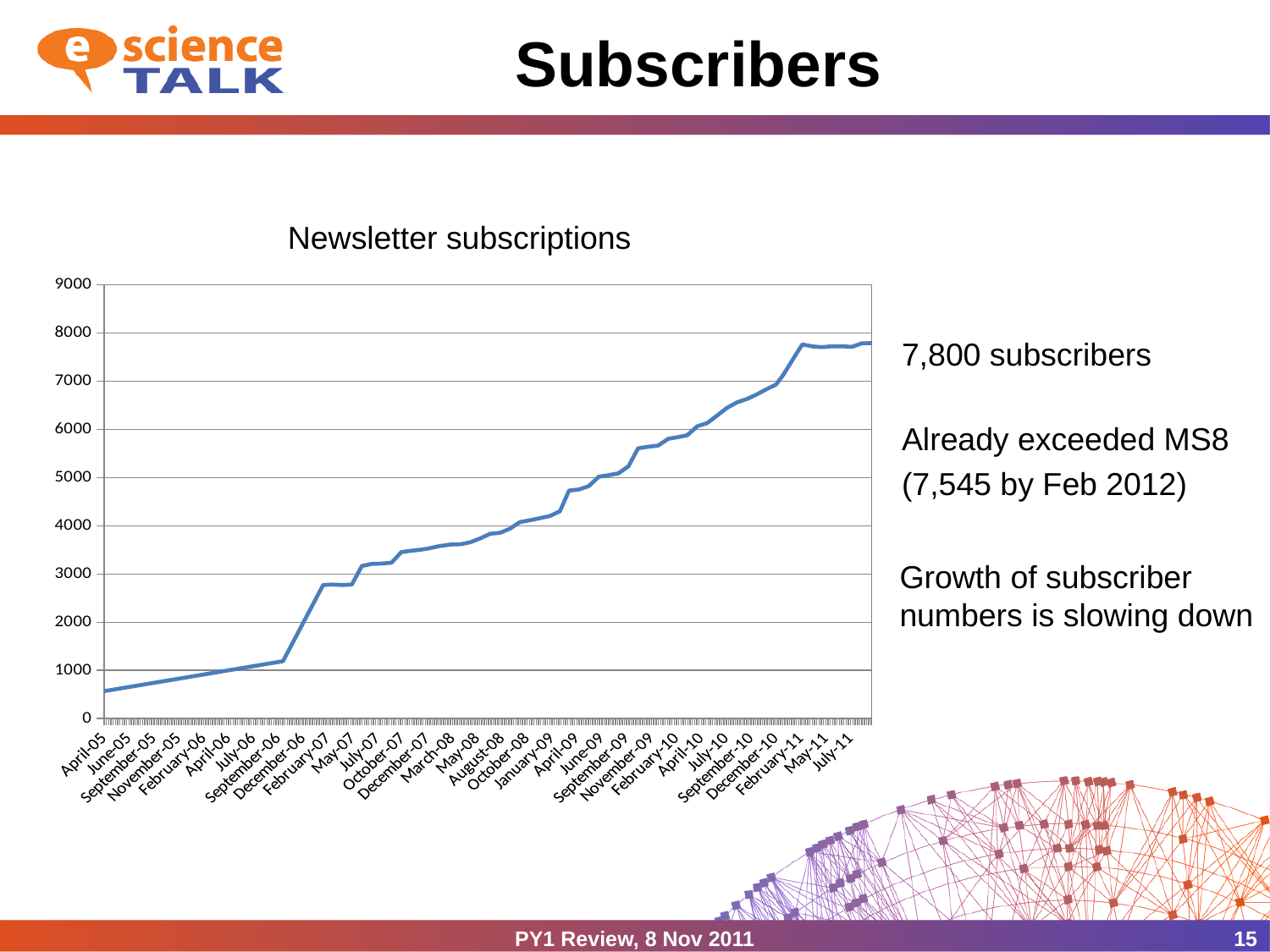
Which has the larger value, July-06 or February-07? February-07 Is the value for July-10 greater or less than 6000? greater Is the value for October-07 greater or less than 3000? greater What is the title of the chart? Newsletter subscriptions Do the newsletter subscription values rise or fall from April-05 to July-11? rise Is the value for July-11 greater or less than 7000? greater What is the highest value shown on the vertical axis? 9000 What kind of chart is shown on the slide? line chart Which has the larger value, April-05 or July-11? July-11